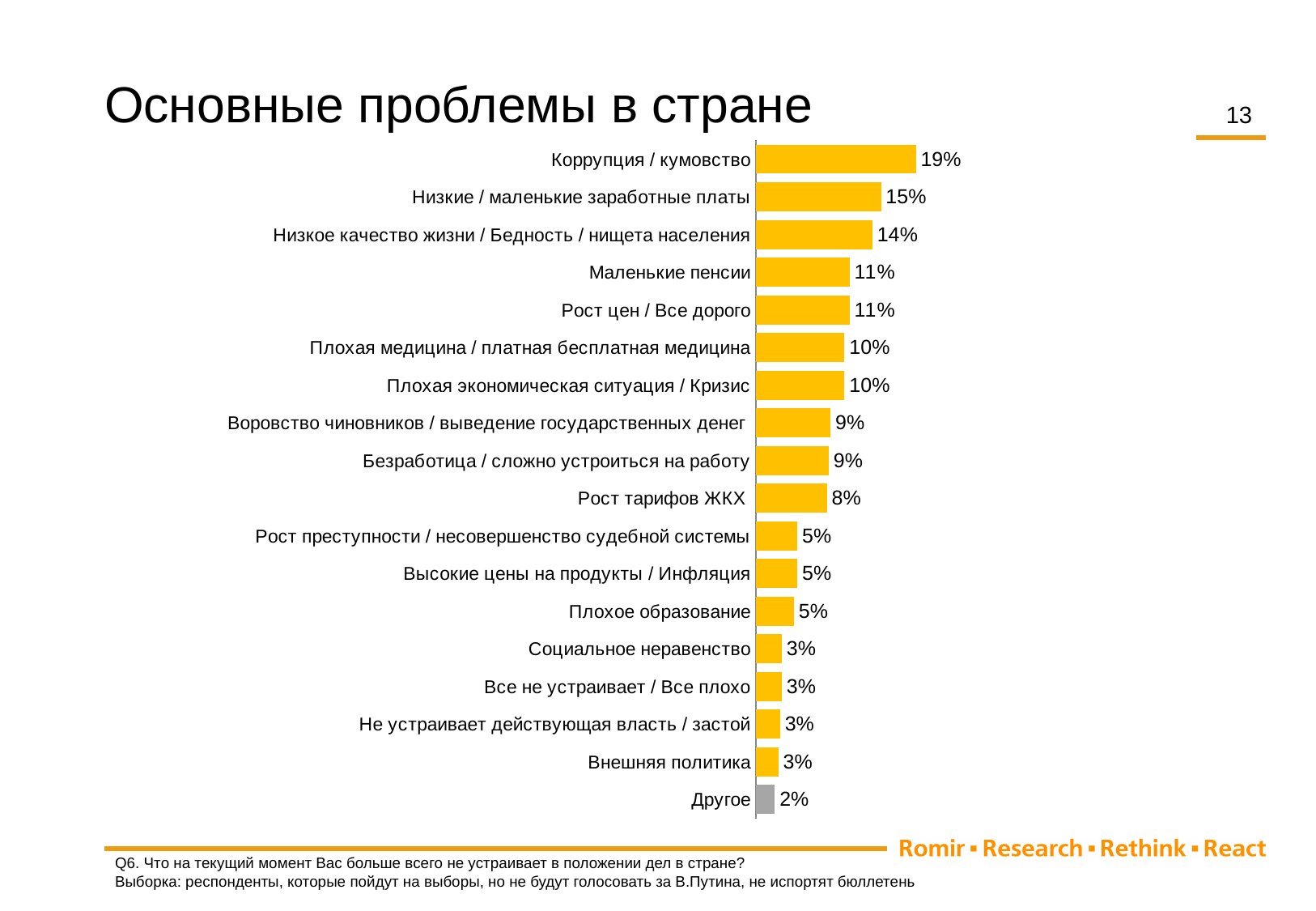
What is the value for Коррупция / кумовство? 19% What is the difference between the values for Безработица / сложно устроиться на работу and Плохое образование? 4% What is the difference between the values for Коррупция / кумовство and Низкие / маленькие заработные платы? 4% What is the value for Рост тарифов ЖКХ? 8% Which bar is coloured differently (grey) from the others? Другое How many categories are shown in the chart? 18 Which is larger: the value for Низкое качество жизни / Бедность / нищета населения or the value for Плохая медицина / платная бесплатная медицина? Низкое качество жизни / Бедность / нищета населения What kind of chart is shown on the slide? Bar chart What is the value for Маленькие пенсии? 11% Which category has the highest value? Коррупция / кумовство What is the value for Другое? 2% Which category has the lowest value? Другое